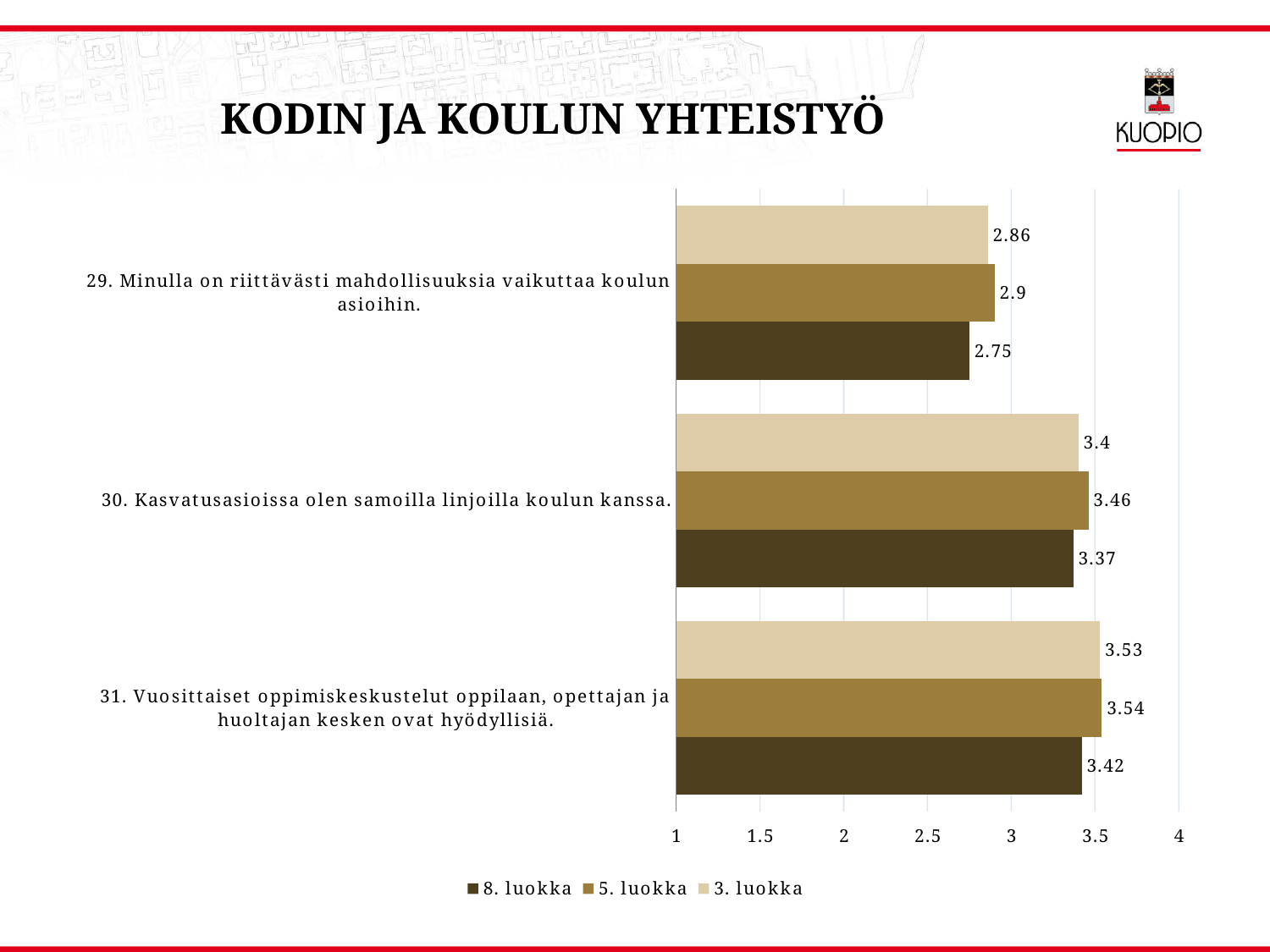
What is the value for 5. luokka on statement 29 (Minulla on riittävästi mahdollisuuksia vaikuttaa koulun asioihin)? 2.9 Which series has the lowest value on statement 29? 8. luokka Which is larger on statement 30: the value for 5. luokka or the value for 8. luokka? 5. luokka How many categories (statements) are plotted on the chart? 3 Is the value for 3. luokka on statement 29 greater or less than 3? less What kind of chart is shown on the slide? Bar chart What is the difference between the 5. luokka and 8. luokka values on statement 29? 0.15 How many series does the legend list? 3 What is the value for 3. luokka on statement 30 (Kasvatusasioissa olen samoilla linjoilla koulun kanssa)? 3.4 What is the title of the slide containing the chart? KODIN JA KOULUN YHTEISTYÖ What is the value for 8. luokka on statement 31 (Vuosittaiset oppimiskeskustelut oppilaan, opettajan ja huoltajan kesken ovat hyödyllisiä)? 3.42 Which statement has the highest value for 5. luokka? 31. Vuosittaiset oppimiskeskustelut oppilaan, opettajan ja huoltajan kesken ovat hyödyllisiä.